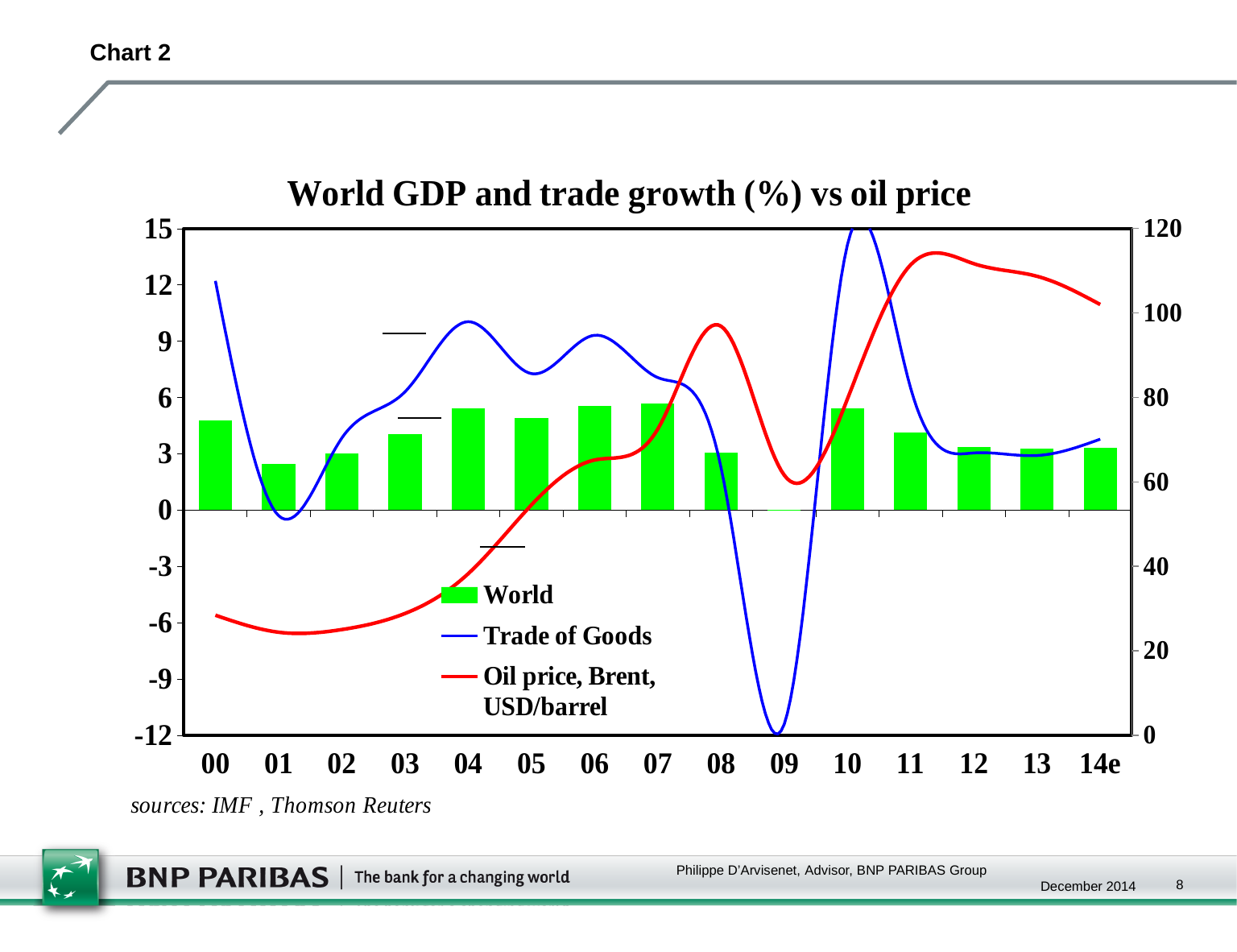
Is the World value for 04 greater or less than 3? greater How many series does the chart's legend list? 3 What is the title of the chart? World GDP and trade growth (%) vs oil price Is the Oil price, Brent value for 00 greater or less than 40? less Is the World value for 01 greater or less than 3? less In which year does the Trade of Goods line reach its lowest point? 09 Which is larger, the World bar for 04 or the World bar for 01? 04 What kind of chart is this? Combined bar and line chart In which year does the Trade of Goods line reach its highest point? 10 Which series is drawn as green bars? World Does the Oil price, Brent line rise or fall from 01 to 08? rise How many years are shown along the x axis? 15